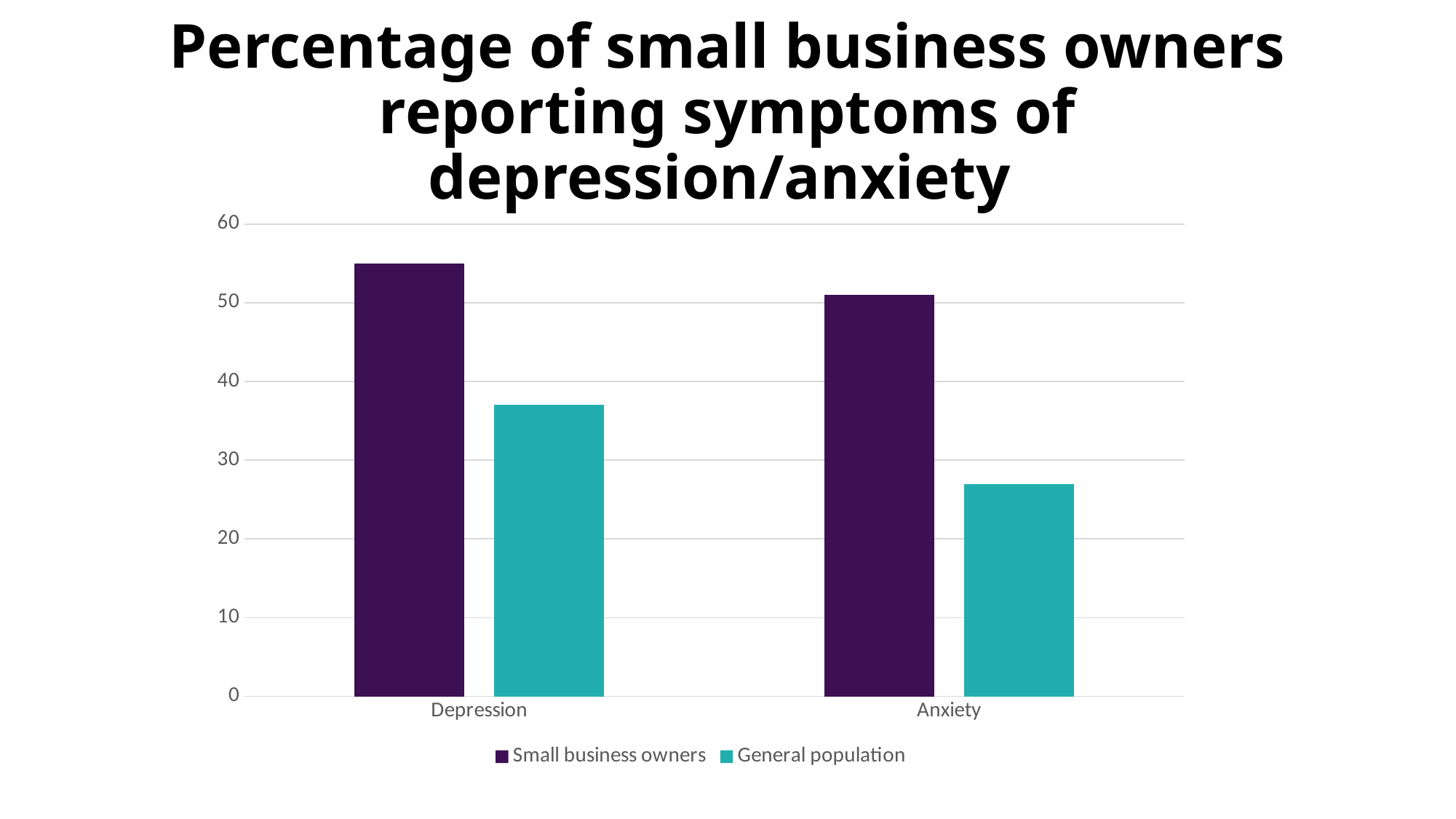
Is the value for General population in the Anxiety category greater or less than 30? less In the Anxiety category, which series has the larger value, Small business owners or General population? Small business owners What kind of chart is shown on the slide? bar chart Does the General population series rise or fall from Depression to Anxiety? fall Is the value for Small business owners in the Anxiety category greater or less than 40? greater Is the value for General population in the Depression category greater or less than 40? less Which bar is the lowest on the chart? General population, Anxiety How many categories are shown on the x axis? 2 How many series does the legend list? 2 Which series is shown in dark purple? Small business owners What is the title of the chart? Percentage of small business owners reporting symptoms of depression/anxiety